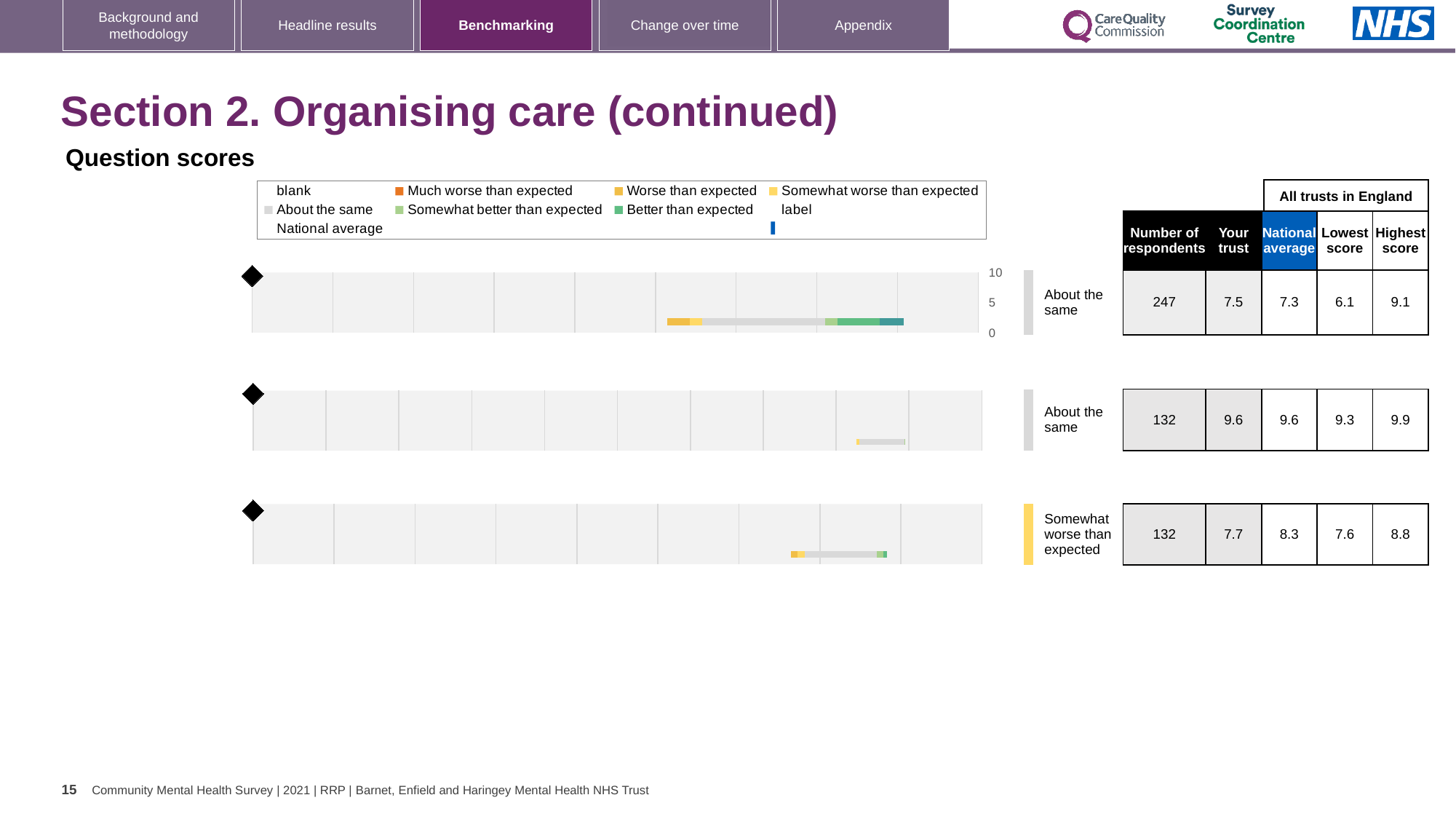
For the bottom chart, what is the difference between the national average (8.3) and the 'Your trust' score (7.7)? 0.6 For the top chart, how many respondents are shown in the table? 247 For the top chart, what is the national average score? 7.3 For the middle chart, what is the highest score among all trusts in England? 9.9 For the middle chart, what is the 'Your trust' score? 9.6 Which of the three charts has the highest 'Your trust' score? The middle chart (9.6) How many benchmarking charts are shown on the slide? 3 For the top chart, what is the 'Your trust' score? 7.5 For the top chart, what is the lowest score among all trusts in England? 6.1 For the top chart, which is larger: the 'Your trust' score or the national average? Your trust What kind of chart is used for the benchmarking displays on this slide? Bar chart For the bottom chart, what benchmark category is the trust placed in? Somewhat worse than expected